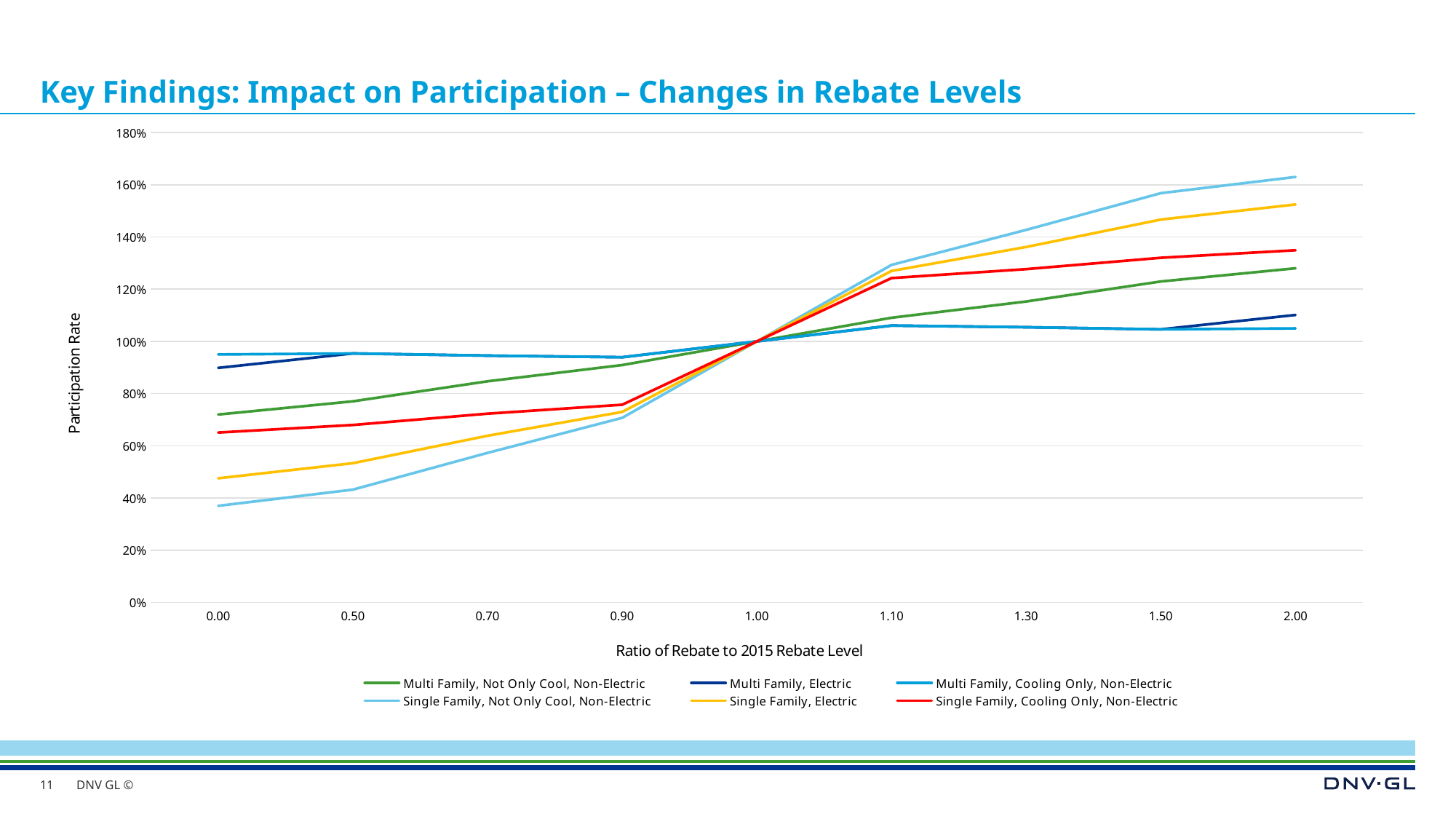
Which series has the highest participation rate at a rebate ratio of 2.00? Single Family, Not Only Cool, Non-Electric At a rebate ratio of 2.00, which is larger: Single Family, Electric or Single Family, Cooling Only, Non-Electric? Single Family, Electric How many rebate ratio values are shown along the x axis? 9 Is the participation rate for Single Family, Not Only Cool, Non-Electric at a rebate ratio of 2.00 greater or less than 160%? greater What is the participation rate for all series at a rebate ratio of 1.00? 100% Is the participation rate for Single Family, Not Only Cool, Non-Electric at a rebate ratio of 0.00 greater or less than 40%? less Which series has the lowest participation rate at a rebate ratio of 0.00? Single Family, Not Only Cool, Non-Electric How many series does the legend list? 6 Is the participation rate for Single Family, Electric at a rebate ratio of 0.00 greater or less than 60%? less Does the participation rate for Single Family, Not Only Cool, Non-Electric rise or fall as the rebate ratio increases from 0.00 to 2.00? rise What is the title of the x axis? Ratio of Rebate to 2015 Rebate Level What kind of chart is shown on the slide? line chart